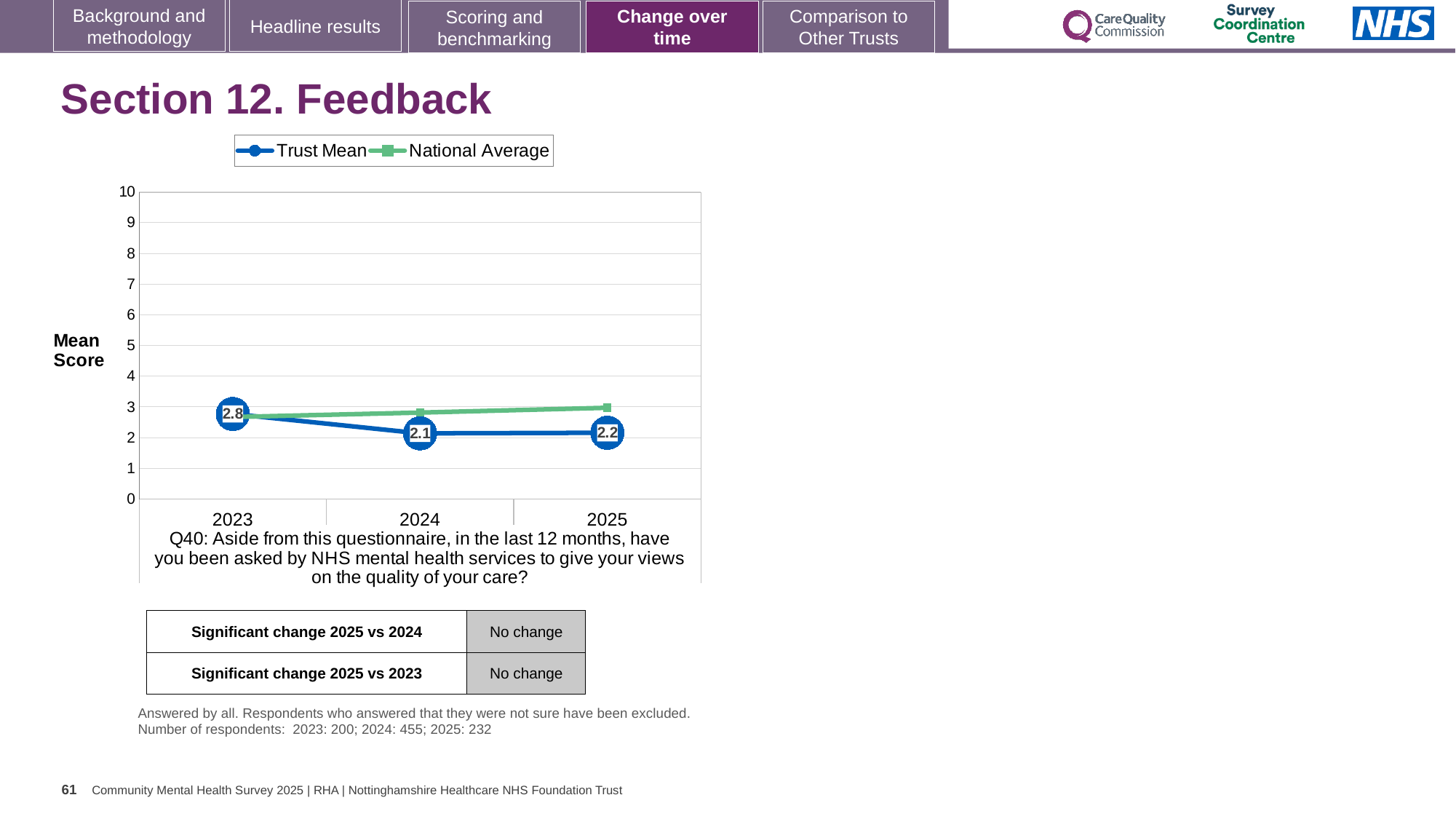
What is the Trust Mean score for 2024? 2.1 How many series does the legend list? 2 How many years are plotted on the x axis? 3 In 2025, which is higher: the Trust Mean or the National Average? National Average What is the difference between the Trust Mean score in 2023 and in 2024? 0.7 In which year is the Trust Mean score highest? 2023 In which year is the Trust Mean score lowest? 2024 What is the Trust Mean score for 2025? 2.2 What kind of chart is shown on the slide? Line chart What is the Trust Mean score for 2023? 2.8 Is the National Average value for 2025 greater or less than 4? less Does the Trust Mean score rise or fall from 2023 to 2025? Fall